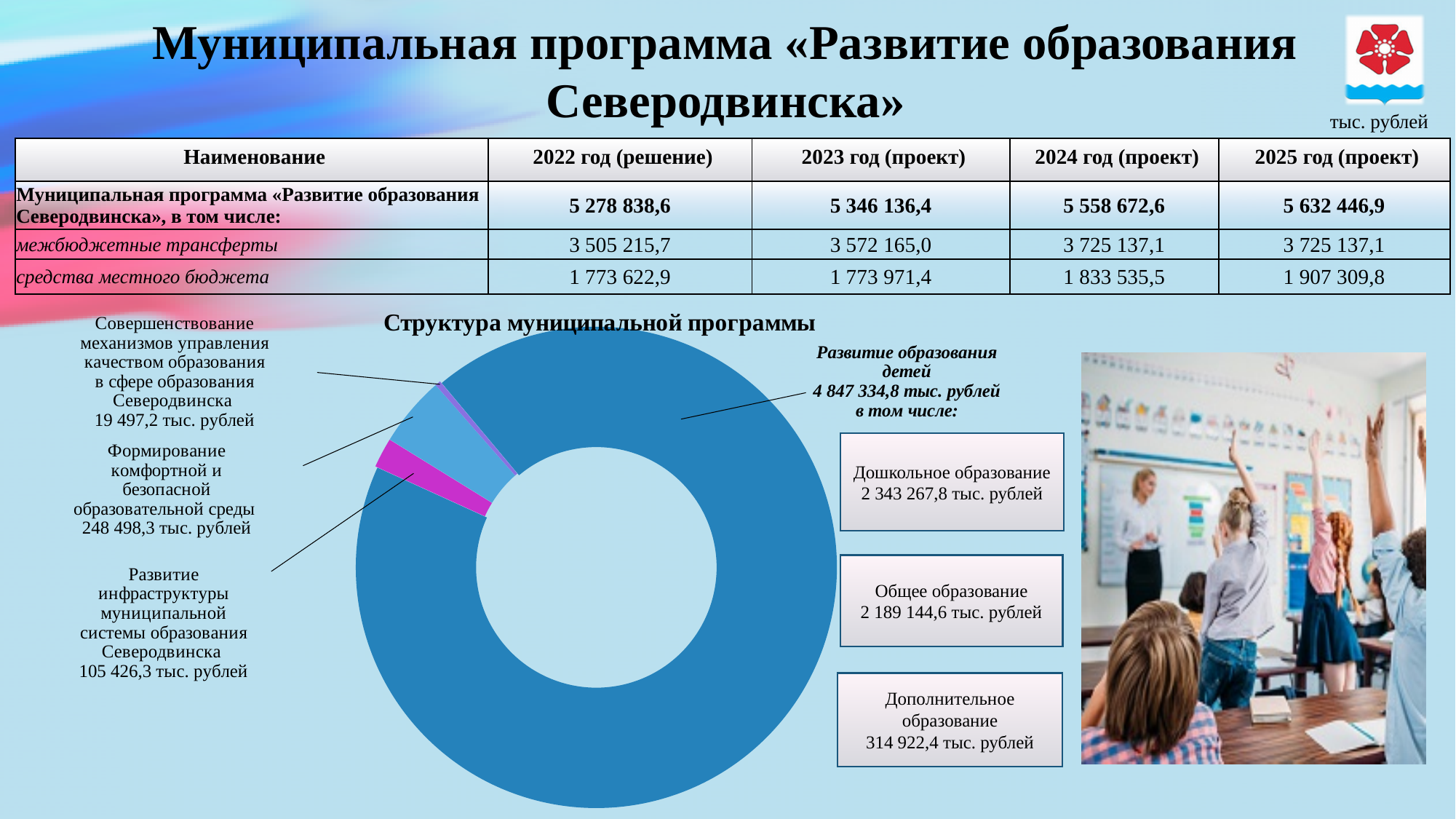
Which slice of the «Структура муниципальной программы» chart is the largest? Развитие образования детей What kind of chart is shown under the heading «Структура муниципальной программы»? Doughnut (pie) chart In the «Структура муниципальной программы» chart, what is the difference between «Развитие инфраструктуры муниципальной системы образования Северодвинска» and «Совершенствование механизмов управления качеством образования»? 85 929,1 тыс. рублей In the «Структура муниципальной программы» chart, what is the value for «Совершенствование механизмов управления качеством образования в сфере образования Северодвинска»? 19 497,2 тыс. рублей In the «Структура муниципальной программы» chart, what is the value for «Формирование комфортной и безопасной образовательной среды»? 248 498,3 тыс. рублей In the «Структура муниципальной программы» chart, what is the difference between «Формирование комфортной и безопасной образовательной среды» and «Развитие инфраструктуры муниципальной системы образования Северодвинска»? 143 072,0 тыс. рублей In the «Структура муниципальной программы» chart, what is the value for «Развитие образования детей»? 4 847 334,8 тыс. рублей In the «Структура муниципальной программы» chart, what is the value for «Развитие инфраструктуры муниципальной системы образования Северодвинска»? 105 426,3 тыс. рублей How many slices does the «Структура муниципальной программы» chart have? 4 What colour is the slice for «Формирование комфортной и безопасной образовательной среды» in the «Структура муниципальной программы» chart? Light blue Which slice of the «Структура муниципальной программы» chart is the smallest? Совершенствование механизмов управления качеством образования в сфере образования Северодвинска In the «Структура муниципальной программы» chart, which is larger: «Формирование комфортной и безопасной образовательной среды» or «Развитие инфраструктуры муниципальной системы образования Северодвинска»? Формирование комфортной и безопасной образовательной среды